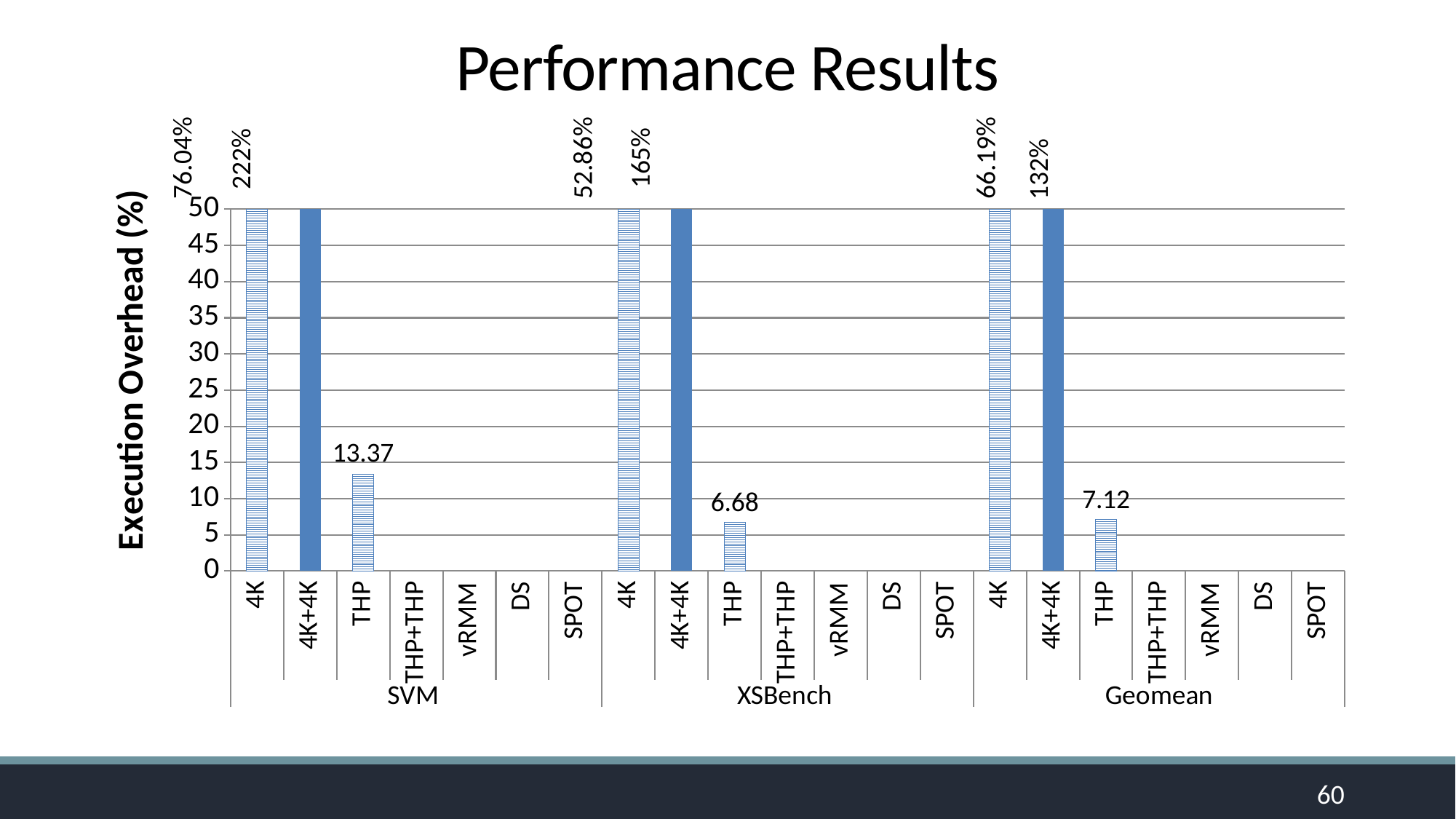
What kind of chart is shown on the slide? bar chart How many benchmark groups are shown along the x axis? 3 Which is larger, the THP value for SVM or the THP value for XSBench? SVM What is the execution overhead for THP in the SVM group? 13.37 What is the execution overhead for THP in the Geomean group? 7.12 What is the execution overhead for 4K+4K in the SVM group? 222% What is the difference between the THP value for SVM and the THP value for XSBench? 6.69 Is the value for 4K in the XSBench group greater or less than 50? greater What is the execution overhead for 4K+4K in the Geomean group? 132% How many configurations are listed within each benchmark group on the x axis? 7 What is the label of the y axis? Execution Overhead (%) What is the execution overhead for THP in the XSBench group? 6.68